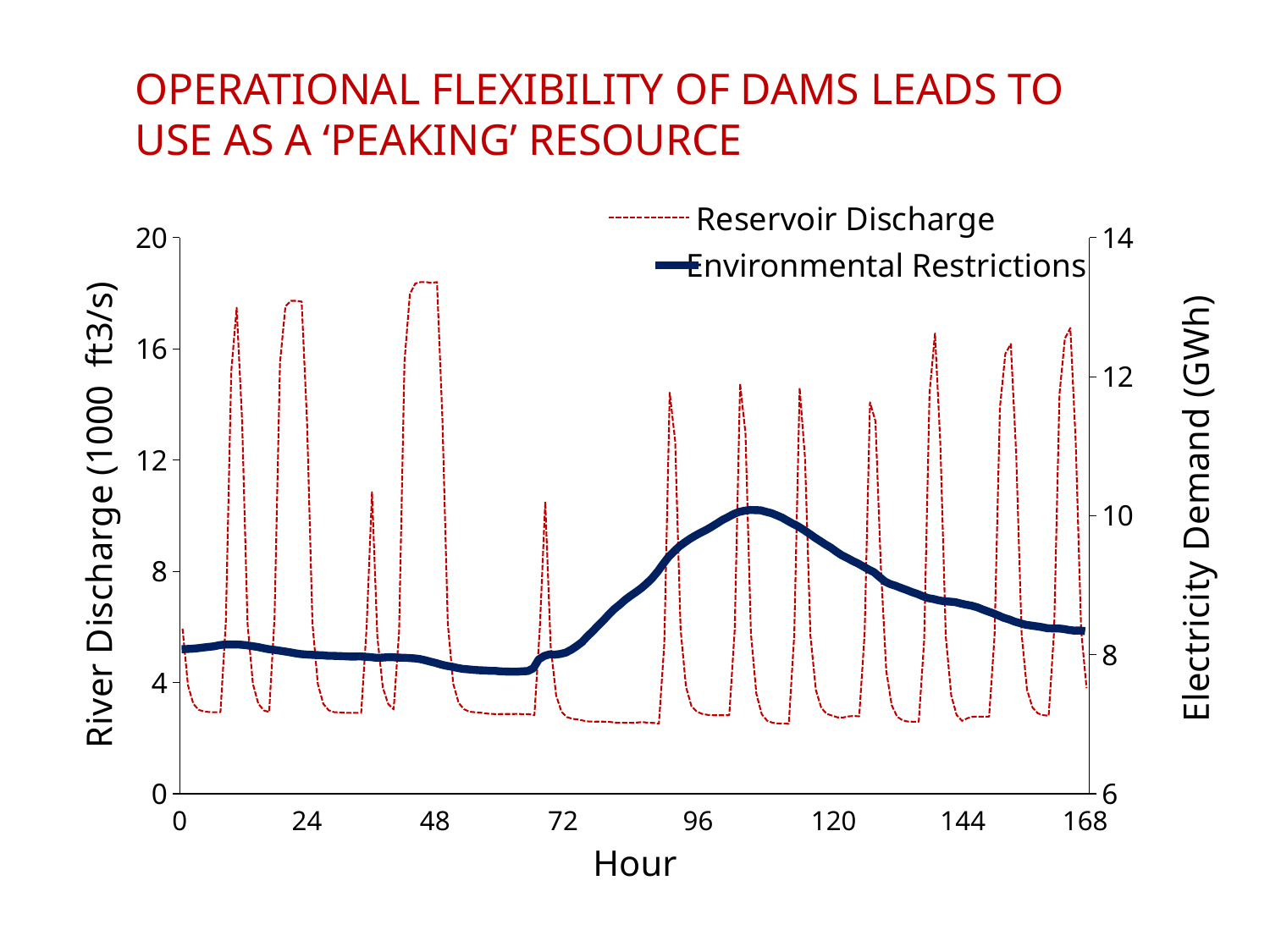
Is the Reservoir Discharge value at hour 80 greater or less than 4 (1000 ft3/s)? less How many series does the legend list? 2 Is the Environmental Restrictions value at hour 168 greater or less than 9 GWh? less Is the peak value of Reservoir Discharge near hour 36 greater or less than 8 (1000 ft3/s)? greater Does the Environmental Restrictions line rise or fall between hour 72 and hour 104? rise Which series is drawn as a red dashed line? Reservoir Discharge Does the Environmental Restrictions line rise or fall between hour 104 and hour 168? fall What is the label of the x axis? Hour What kind of chart is shown on the slide? line chart